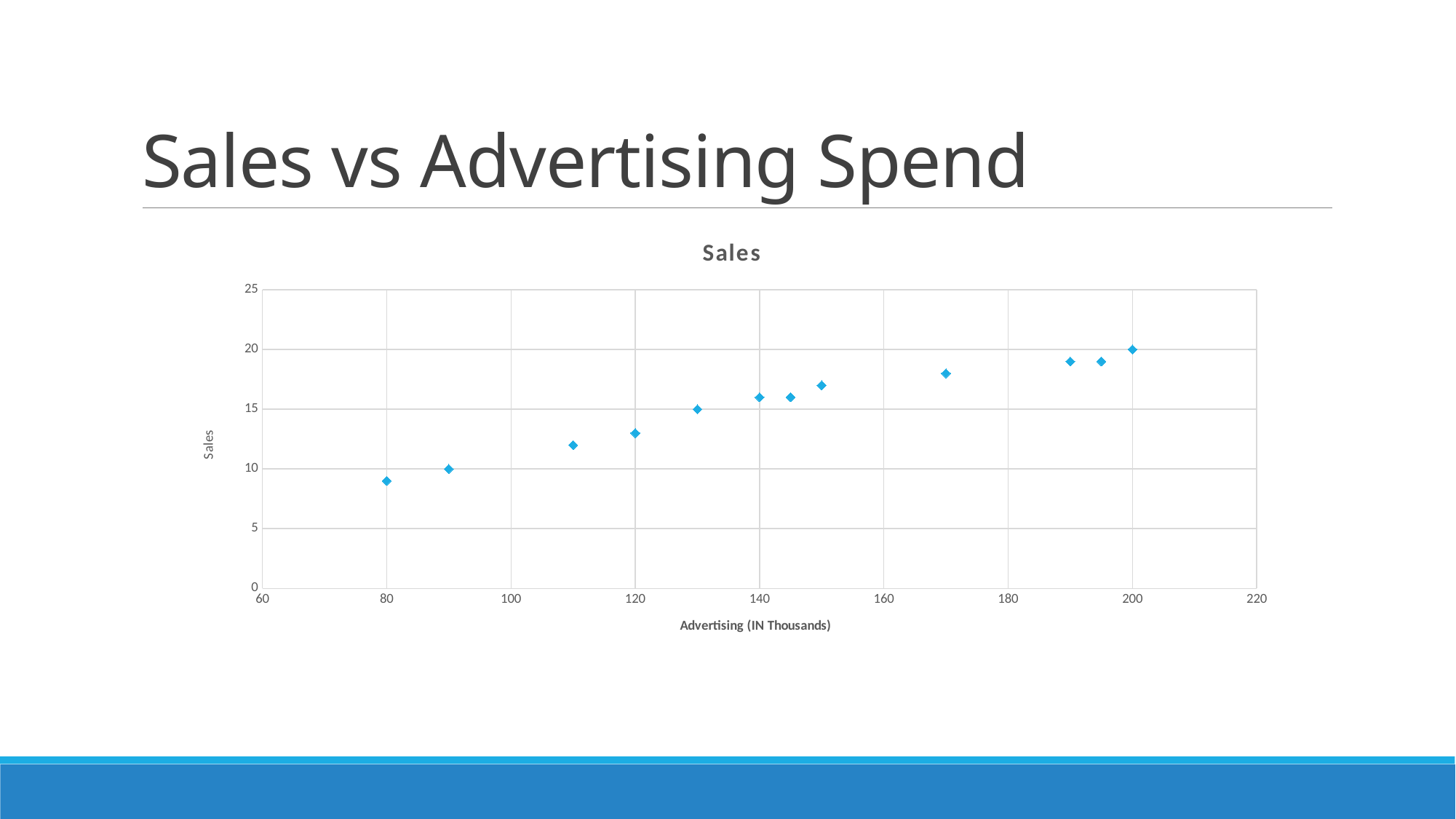
Is the sales value for the point at an advertising spend of 80 greater or less than 10? less Do sales rise or fall as advertising spend increases along the x axis? rise At which advertising spend is the sales value highest? 200 Which has the higher sales value: the point at advertising spend 120 or the point at advertising spend 140? 140 Is the sales value for the point at an advertising spend of 120 greater or less than 15? less How many data points are plotted in the chart? 12 What is the sales value for the point at an advertising spend of 200? 20 What is the title of the x axis? Advertising (IN Thousands) At which advertising spend is the sales value lowest? 80 What kind of chart is shown on the slide? scatter chart What is the title of the chart? Sales Is the sales value for the point at an advertising spend of 140 greater or less than 15? greater